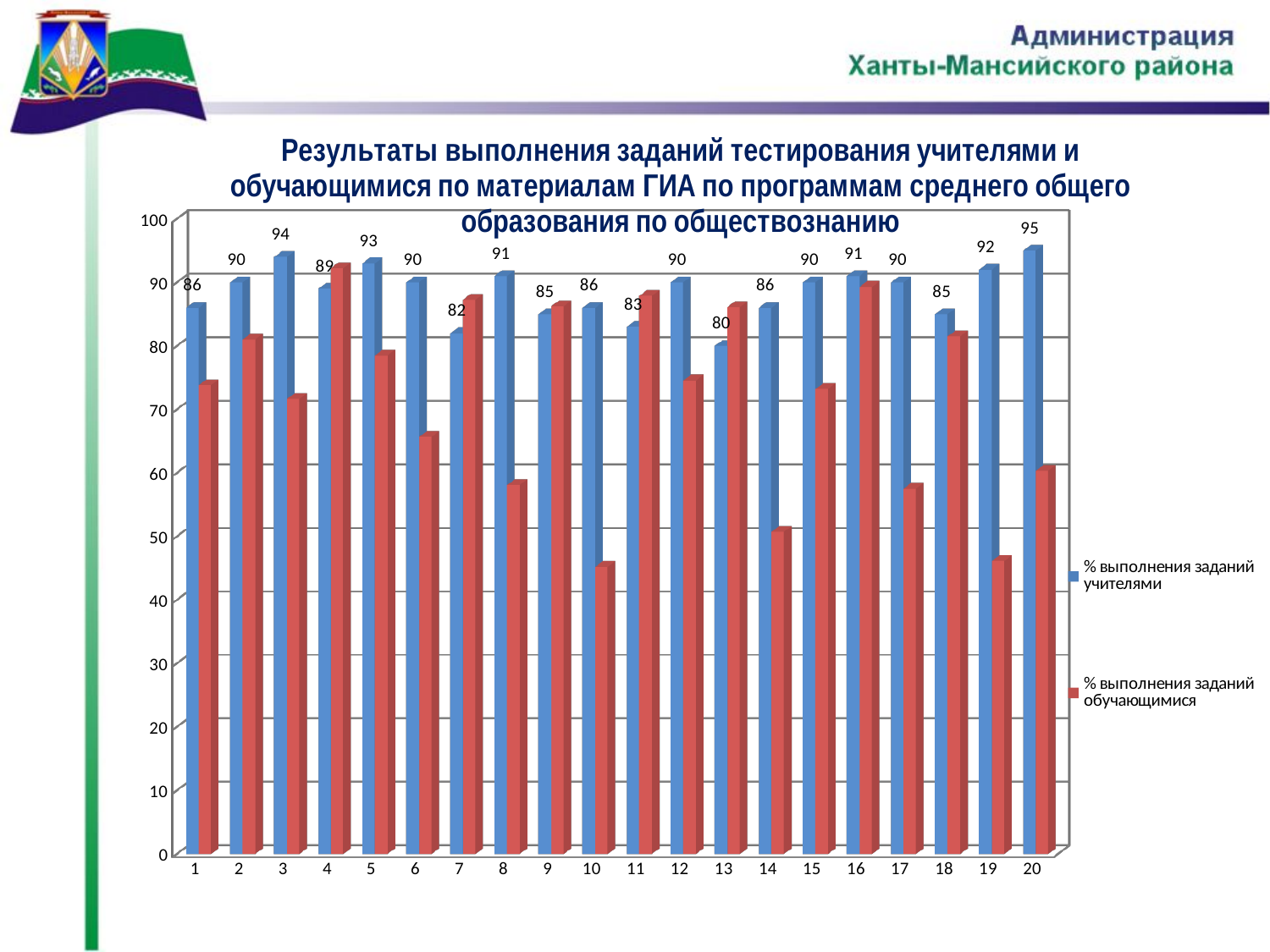
What is the difference between the "% выполнения заданий учителями" values for category 20 and category 13? 15 How many series does the legend list? 2 What is the value of "% выполнения заданий учителями" for category 7? 82 Is the value of "% выполнения заданий обучающимися" for category 10 greater or less than 50? less Is the value of "% выполнения заданий обучающимися" for category 16 greater or less than 80? greater For category 10, which series has the larger value: "% выполнения заданий учителями" or "% выполнения заданий обучающимися"? % выполнения заданий учителями What is the value of "% выполнения заданий учителями" for category 13? 80 Which category has the lowest value for "% выполнения заданий учителями"? 13 Which category has the highest value for "% выполнения заданий учителями"? 20 What kind of chart is shown on the slide? Bar chart How many categories are shown on the x axis? 20 What is the value of "% выполнения заданий учителями" for category 3? 94